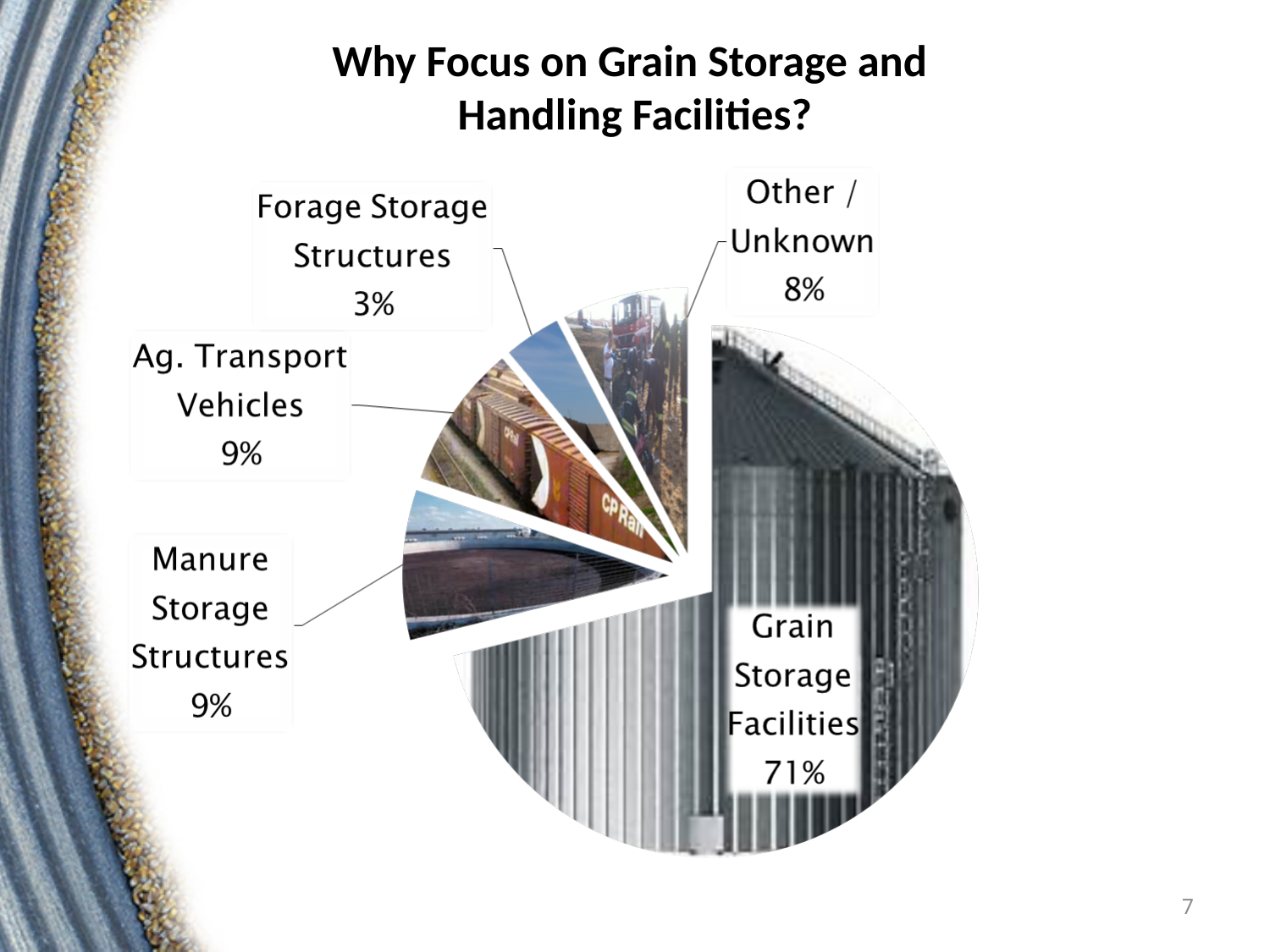
What share of the pie is Grain Storage Facilities? 71% What is the value for Manure Storage Structures? 9% What is the difference between the Grain Storage Facilities share and the Other / Unknown share? 63% Which category has the largest slice of the pie? Grain Storage Facilities Which is larger, Other / Unknown or Forage Storage Structures? Other / Unknown What kind of chart is shown on the slide? pie chart What is the value for Other / Unknown? 8% How many categories are shown in the pie chart? 5 Which category has the smallest slice of the pie? Forage Storage Structures What is the title of the slide containing the pie chart? Why Focus on Grain Storage and Handling Facilities? What is the value for Ag. Transport Vehicles? 9% What is the value for Forage Storage Structures? 3%